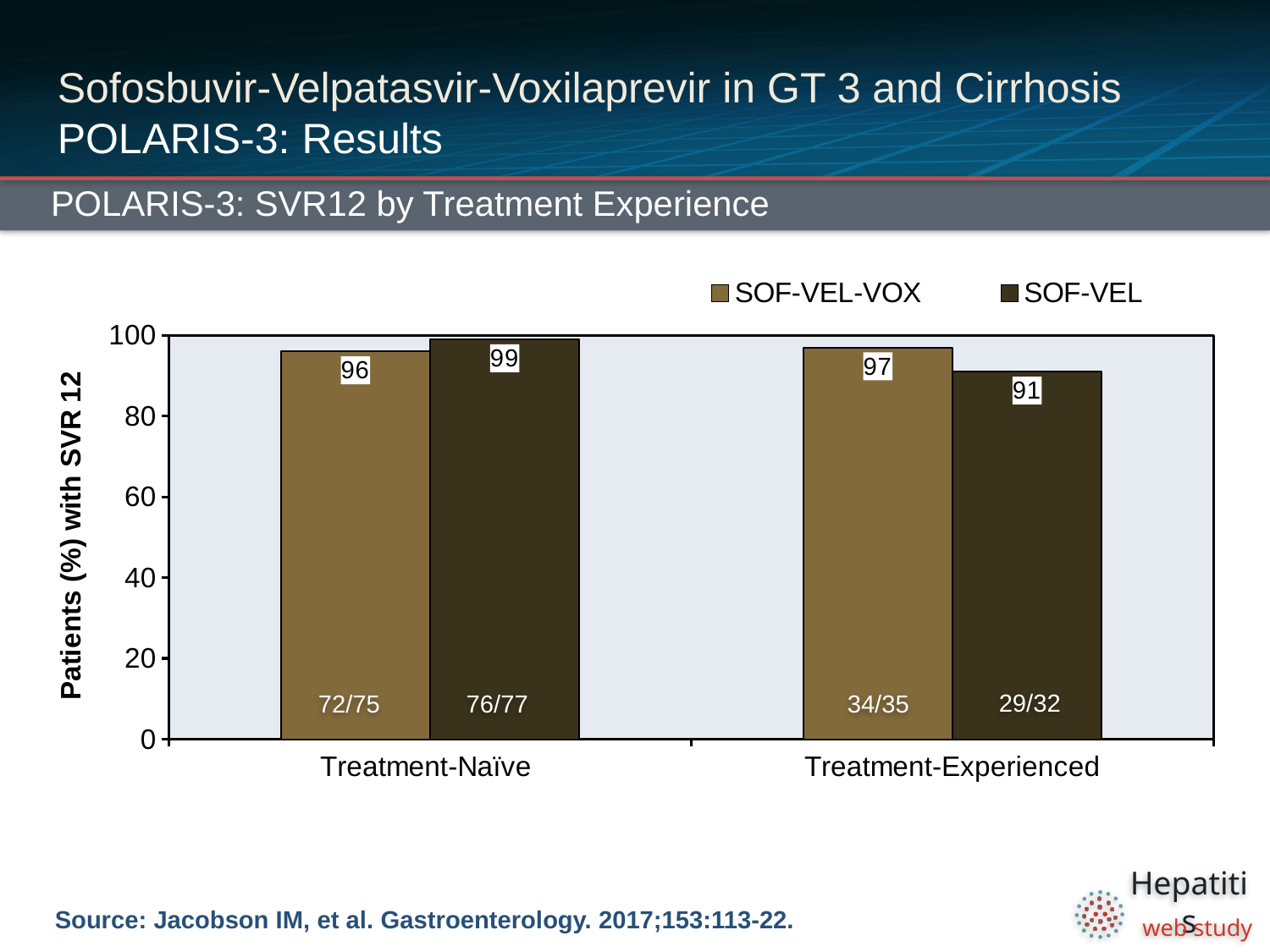
In the Treatment-Naïve group, which series has the higher SVR12 rate, SOF-VEL-VOX or SOF-VEL? SOF-VEL What fraction of patients is shown for SOF-VEL-VOX in the Treatment-Experienced group? 34/35 What is the SVR12 rate for SOF-VEL in the Treatment-Naïve group? 99 Which bar has the highest SVR12 rate on the chart? SOF-VEL, Treatment-Naïve What is the label of the y axis? Patients (%) with SVR 12 What is the difference in SVR12 rate between SOF-VEL-VOX and SOF-VEL in the Treatment-Experienced group? 6 How many series does the legend list? 2 Which bar has the lowest SVR12 rate on the chart? SOF-VEL, Treatment-Experienced How many categories are shown on the x axis? 2 What is the SVR12 rate for SOF-VEL in the Treatment-Experienced group? 91 What kind of chart is shown on the slide? Bar chart What is the SVR12 rate for SOF-VEL-VOX in the Treatment-Naïve group? 96